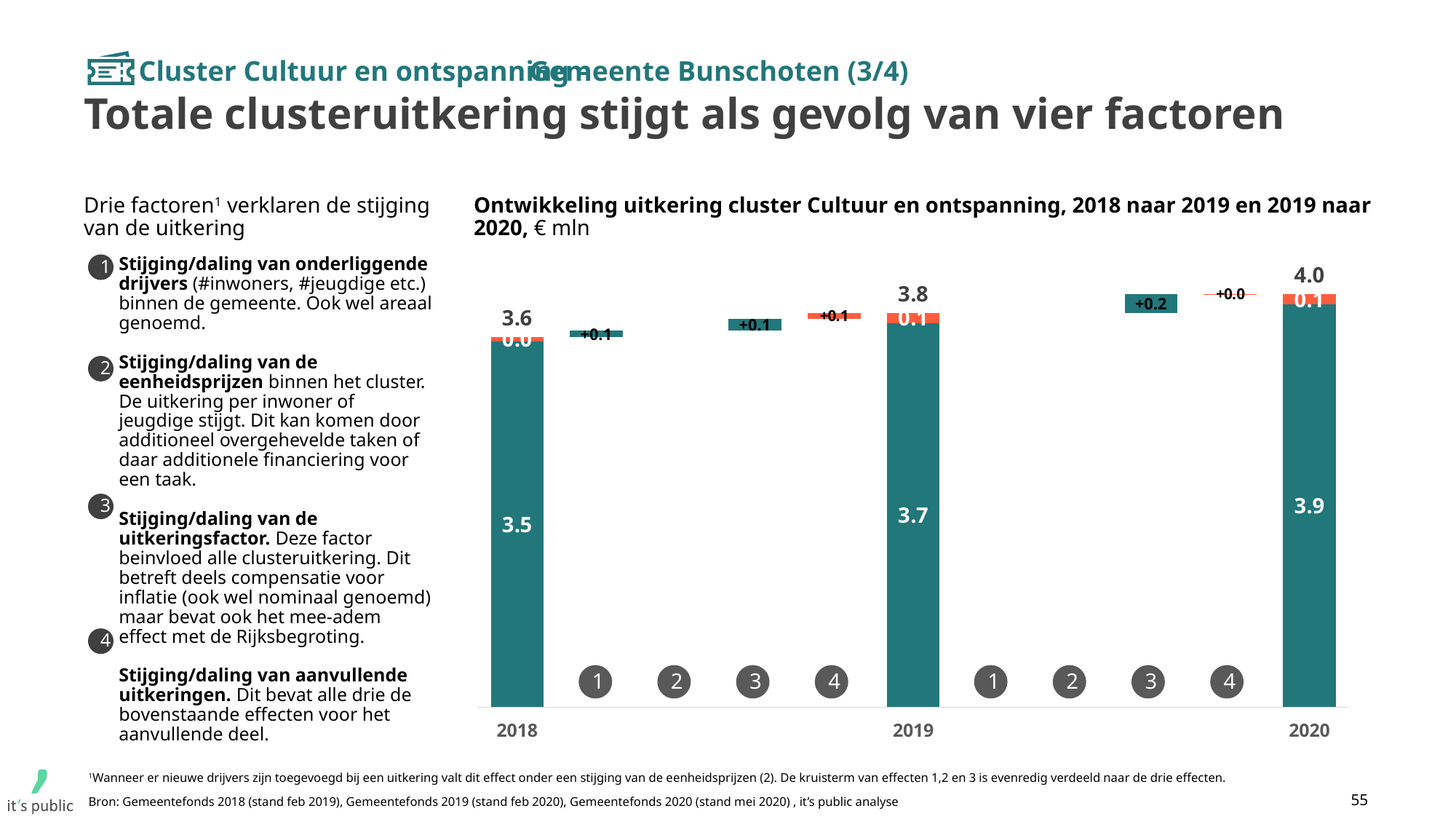
In what unit are the values on the chart expressed? € mln What is the total uitkering for 2019 shown on the chart? 3.8 What is the total uitkering for 2018 shown on the chart? 3.6 By how much does the total uitkering in 2020 exceed that of 2018? 0.4 Which year has the lowest total uitkering? 2018 What is the effect of factor 3 between 2019 and 2020? +0.2 What is the effect of factor 4 between 2019 and 2020? +0.0 Which year has the highest total uitkering? 2020 What is the total uitkering for 2020 shown on the chart? 4.0 What is the value of the large teal segment of the 2020 bar? 3.9 What is the effect of factor 1 between 2018 and 2019? +0.1 What is the value of the large teal segment of the 2018 bar? 3.5